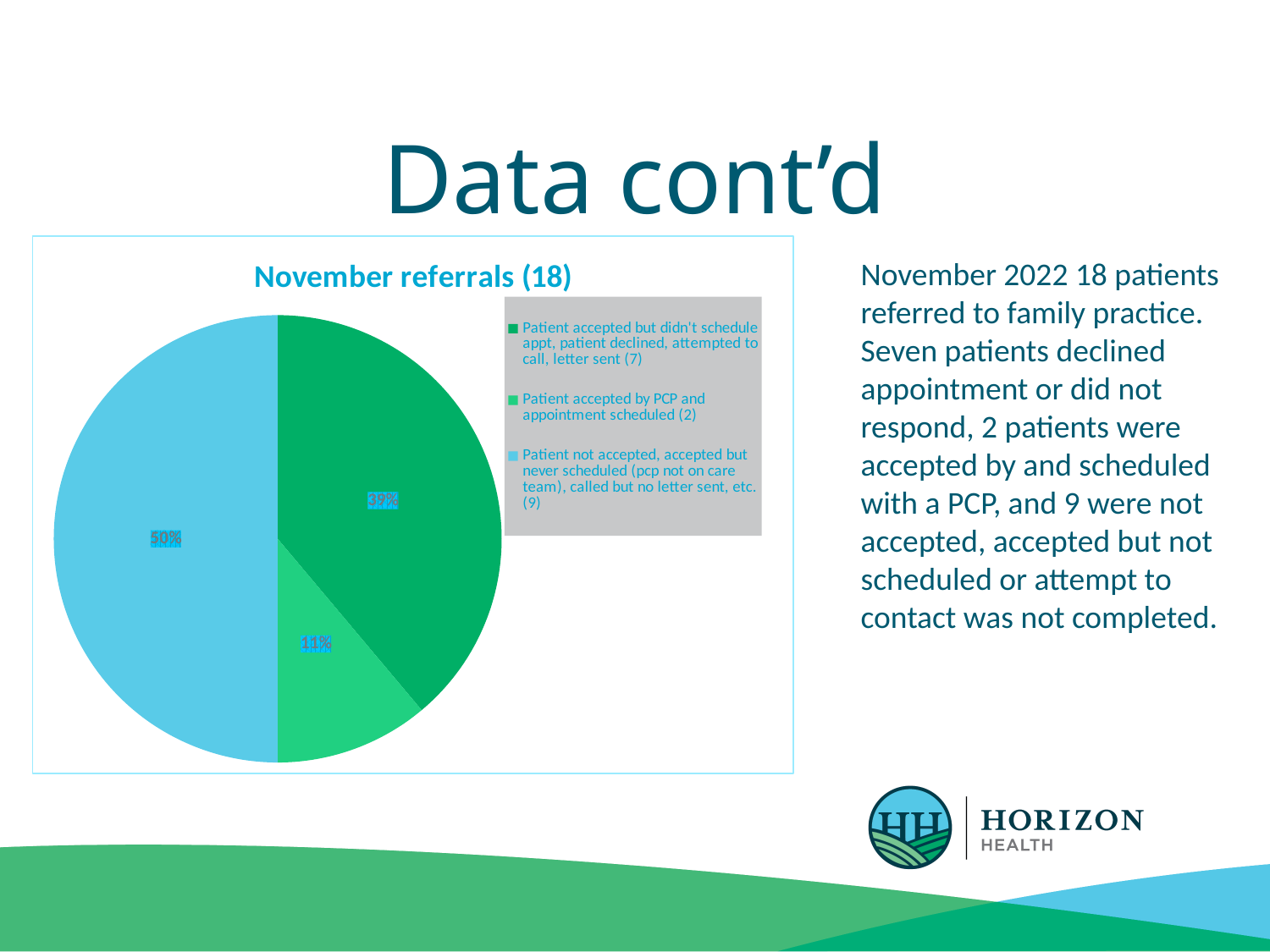
What percentage of the pie is the slice for 'Patient accepted but didn't schedule appt, patient declined, attempted to call, letter sent (7)'? 39% How many entries does the legend of the pie chart list? 3 What colour is the slice labelled 50%? light blue What is the difference in percentage points between the 50% slice and the 39% slice? 11 How many slices does the pie chart have? 3 What percentage of the pie is the slice for 'Patient accepted by PCP and appointment scheduled (2)'? 11% What type of chart is shown on the slide? pie chart Which legend category has the largest slice of the pie? Patient not accepted, accepted but never scheduled (pcp not on care team), called but no letter sent, etc. (9) Which slice is larger: the one labelled 39% or the one labelled 11%? 39% What percentage of the pie is the slice for 'Patient not accepted, accepted but never scheduled (pcp not on care team), called but no letter sent, etc. (9)'? 50% What is the title of the pie chart? November referrals (18) Which legend category has the smallest slice of the pie? Patient accepted by PCP and appointment scheduled (2)